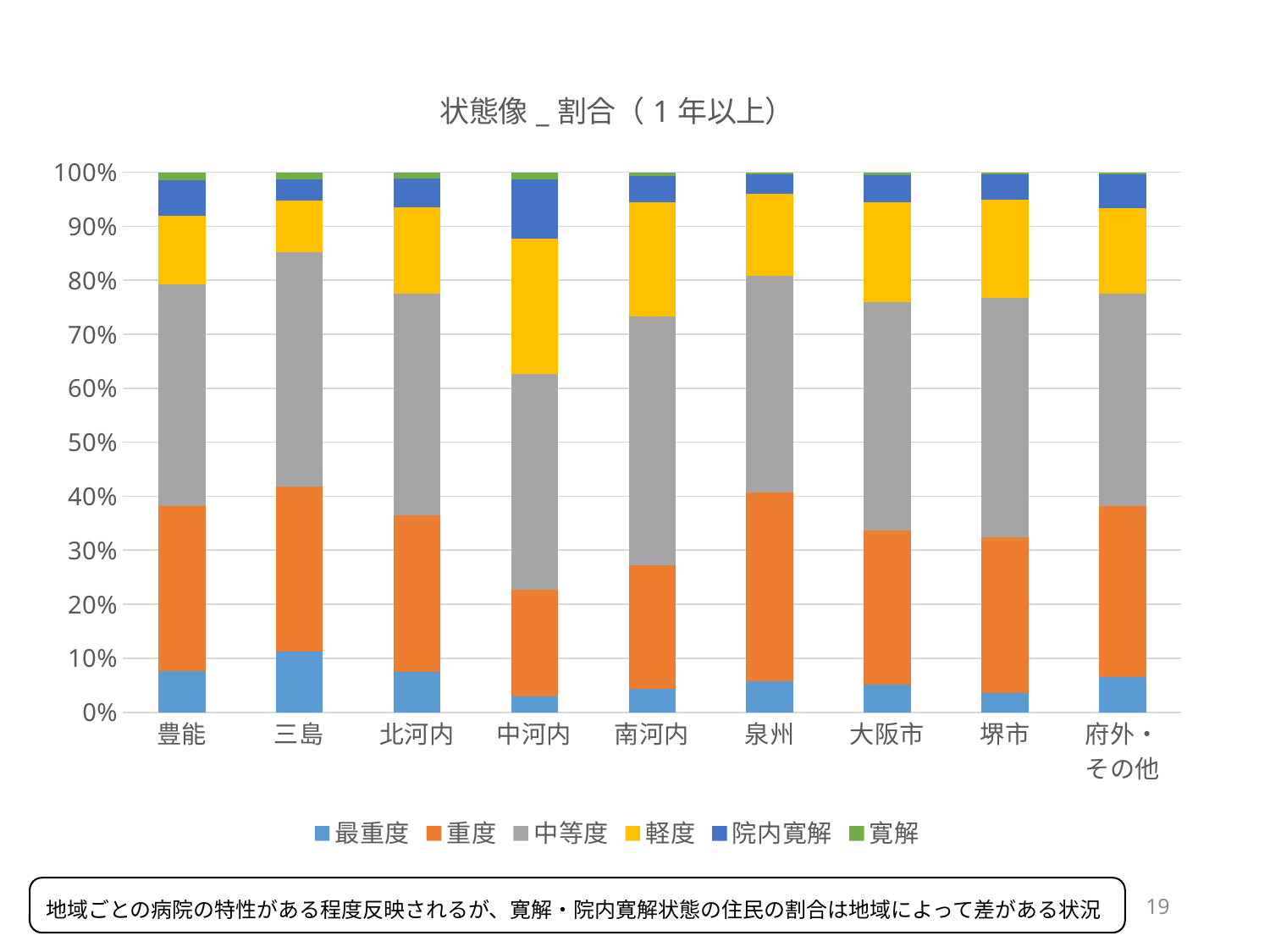
What does each stacked bar total? 100% How many series does the legend list? 6 Is the combined share of 最重度 and 重度 for 中河内 greater or less than 30%? less Is the 最重度 share for 三島 greater or less than 10%? greater What kind of chart is shown on the slide? Stacked bar chart Which region has the largest 院内寛解 share? 中河内 How many categories (regions) are shown on the x axis? 9 Which region has the largest 軽度 share? 中河内 Which series is shown in orange in the legend? 重度 What is the title of the chart? 状態像_割合（1年以上） Which region has the largest 最重度 share? 三島 Which region has the larger 重度 share, 三島 or 中河内? 三島